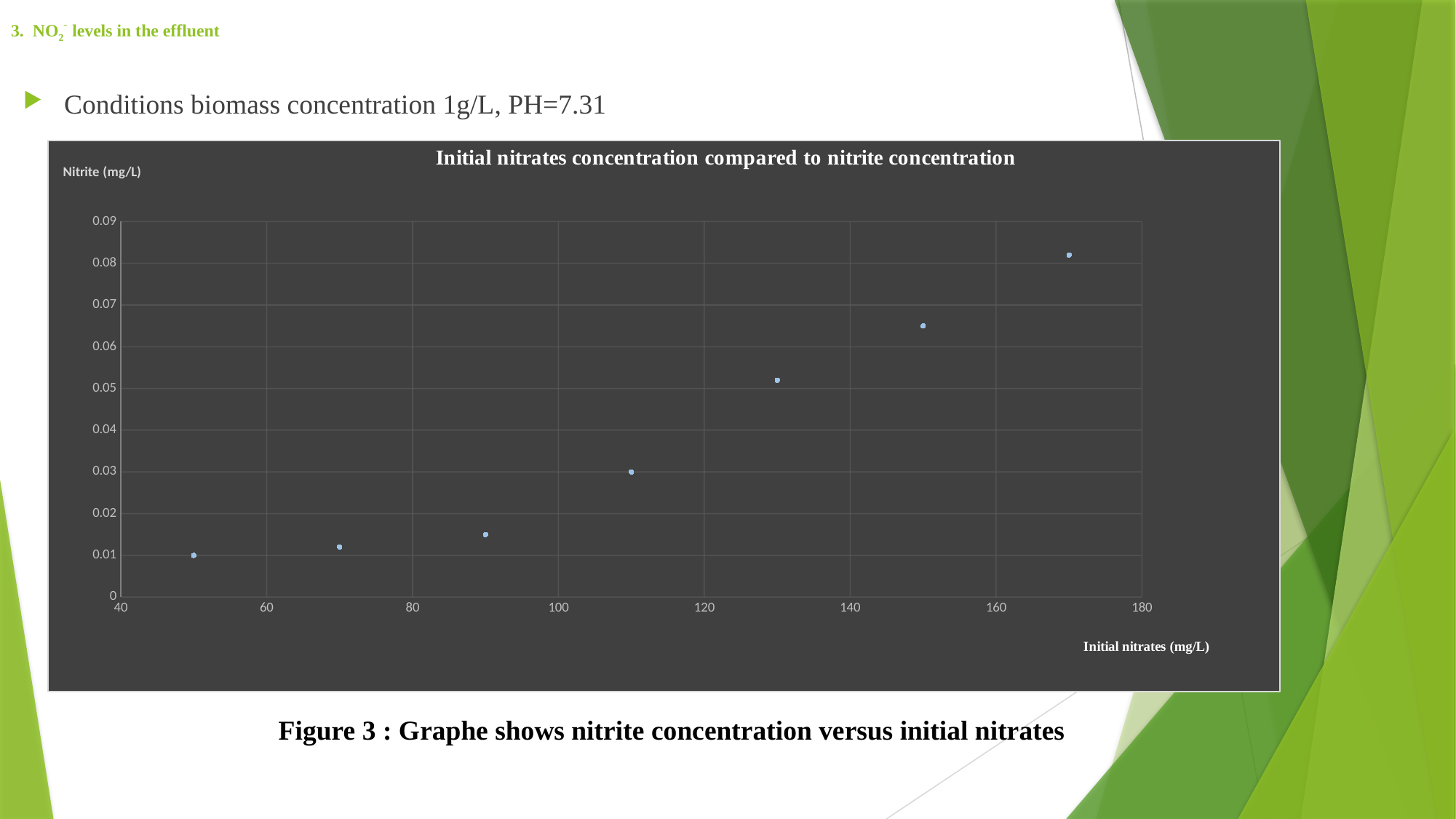
Is the nitrite value at an initial nitrates concentration of 170 mg/L greater or less than 0.08? greater What kind of chart is shown on the slide? scatter chart Is the nitrite value at an initial nitrates concentration of 130 mg/L greater or less than 0.06? less How many data points are plotted on the chart? 7 At which initial nitrates concentration is the nitrite concentration highest? 170 What is the title of the chart? Initial nitrates concentration compared to nitrite concentration Does the nitrite concentration rise or fall as the initial nitrates concentration increases? rise What is the nitrite concentration at an initial nitrates concentration of 110 mg/L? 0.03 At which initial nitrates concentration is the nitrite concentration lowest? 50 What is the label of the vertical axis of the chart? Nitrite (mg/L) What is the nitrite concentration at an initial nitrates concentration of 50 mg/L? 0.01 Is the nitrite value at an initial nitrates concentration of 150 mg/L greater or less than 0.06? greater